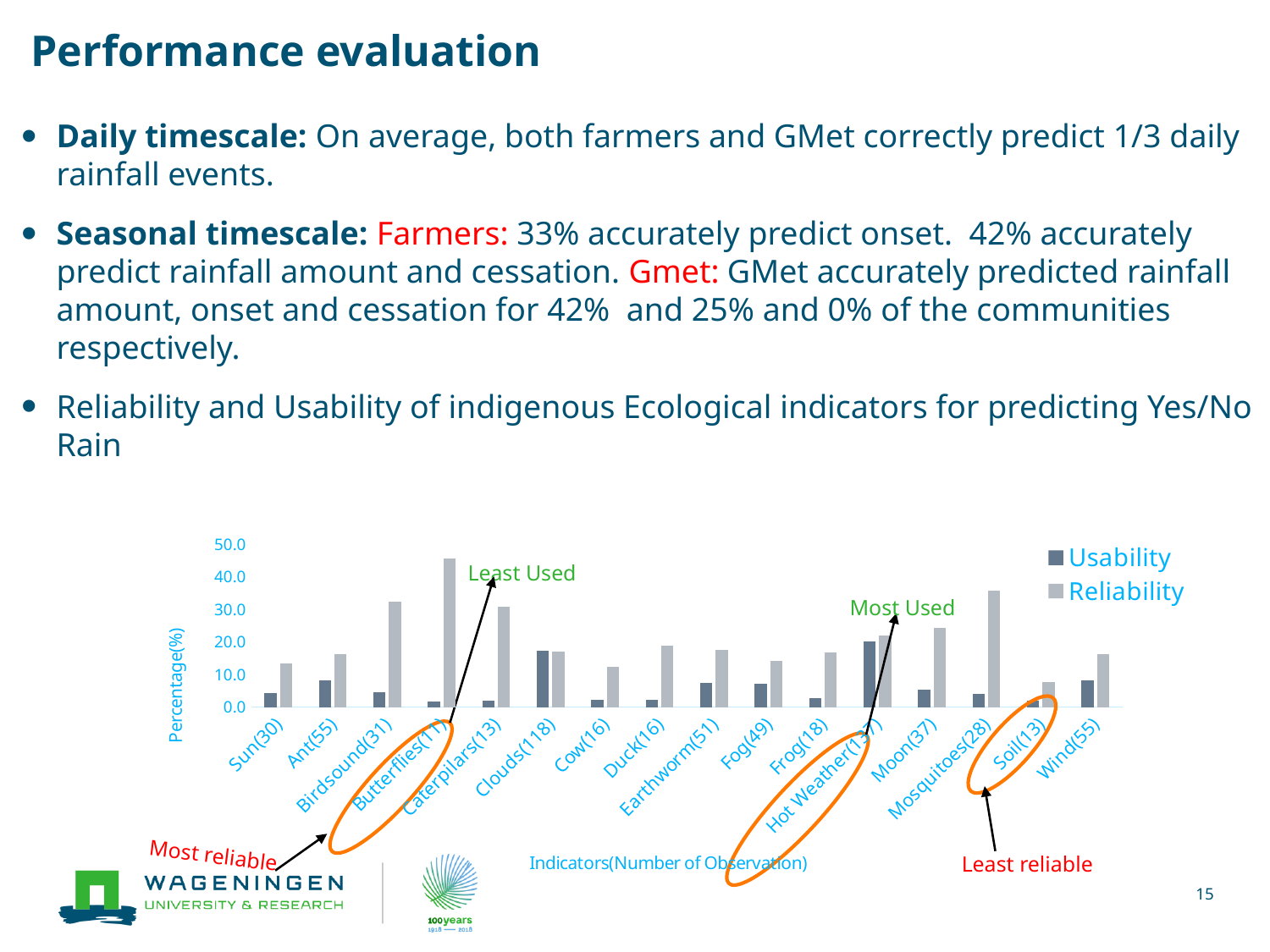
Which indicator has the highest Usability value in the chart? Hot Weather How many indicator categories are shown on the x axis of the chart? 16 Is the Usability value for Clouds(118) greater or less than 10? greater Which indicator has the highest Reliability value in the chart? Butterflies(11) Which indicator has the lowest Reliability value in the chart? Soil(13) What kind of chart is shown on the slide? bar chart Is the Reliability value for Butterflies(11) greater or less than 40? greater Is the Reliability value for Mosquitoes(28) greater or less than 30? greater How many series does the chart legend list? 2 Which is larger, the Reliability value for Butterflies(11) or the Reliability value for Mosquitoes(28)? Butterflies(11) What is the label on the y axis of the chart? Percentage(%)